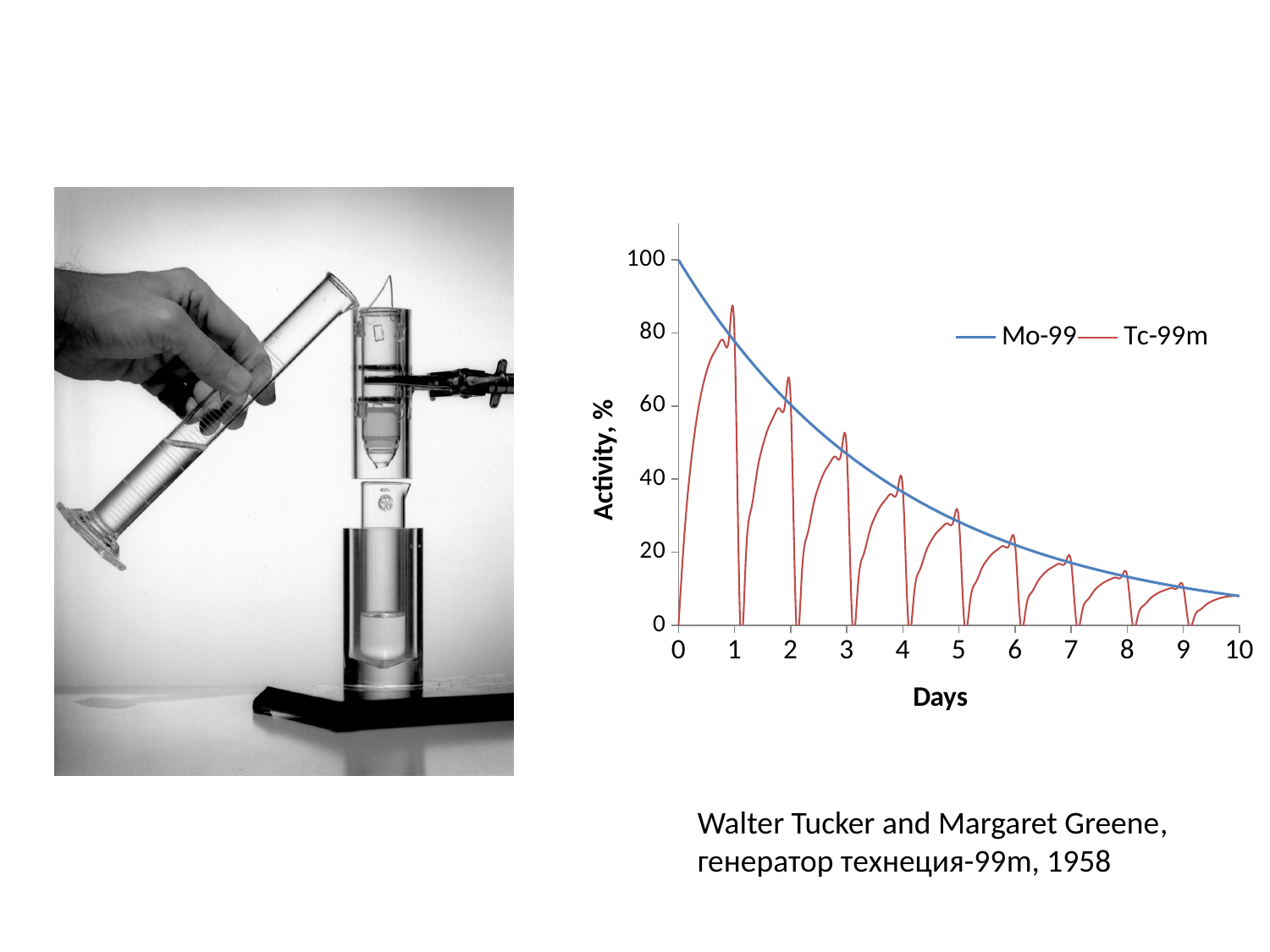
What kind of chart is shown on the slide? line chart What are the two series named in the chart legend? Mo-99 and Tc-99m What is the label of the vertical axis of the chart? Activity, % Does the Mo-99 activity rise or fall as the number of days increases? fall What is the Mo-99 activity value at day 0? 100 How many series does the chart legend list? 2 Is the Mo-99 activity at day 5 greater or less than 40? less Is the Mo-99 activity at day 10 greater or less than 20? less Is the Mo-99 activity at day 3 greater or less than 40? greater At day 0, which series has the higher activity, Mo-99 or Tc-99m? Mo-99